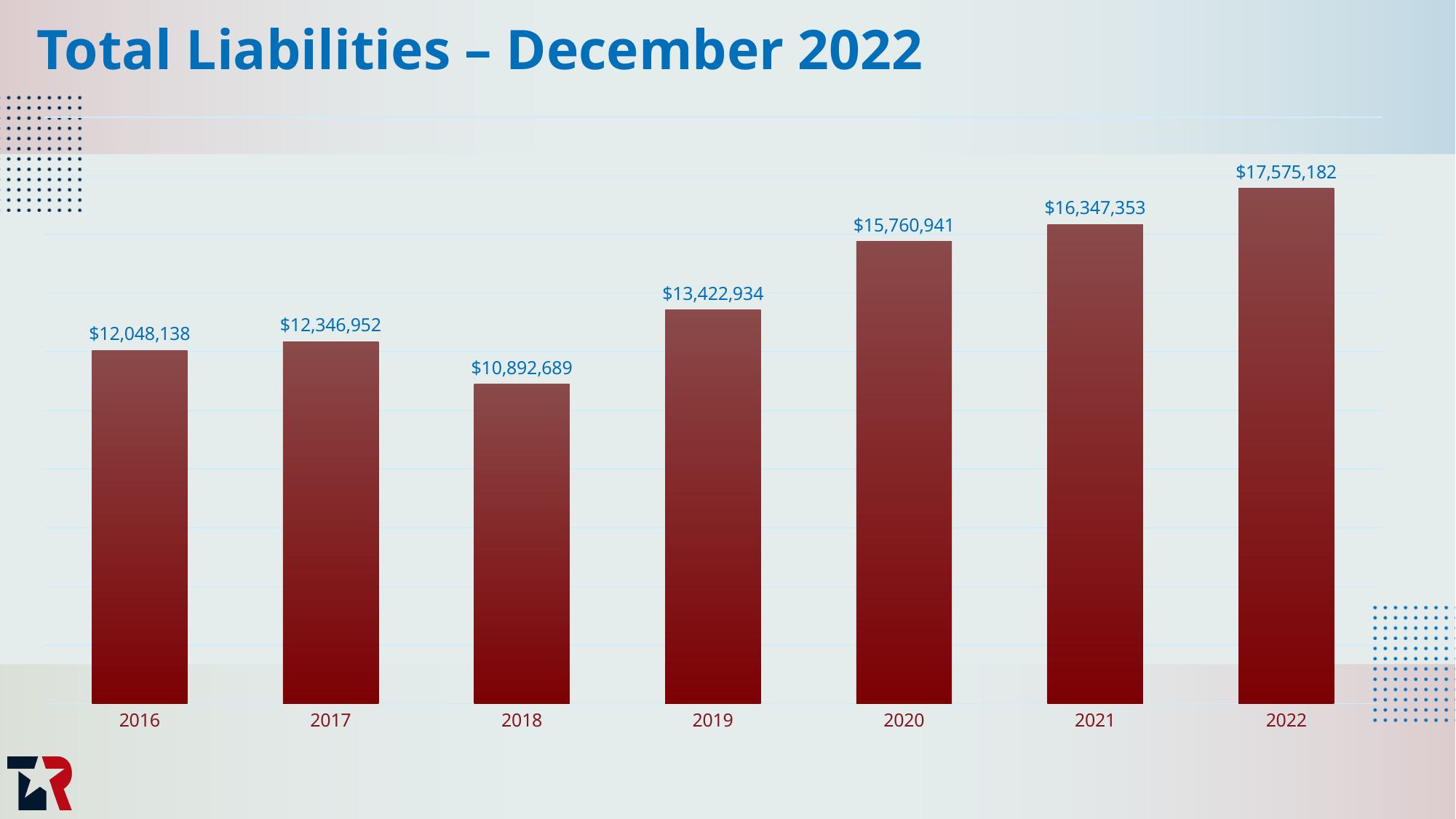
What is the title of the slide? Total Liabilities – December 2022 What is the total liabilities value for 2016? $12,048,138 How many years are shown on the chart? 7 What is the difference in total liabilities between 2022 and 2021? $1,227,829 Which year has the lowest total liabilities? 2018 What is the difference in total liabilities between 2019 and 2018? $2,530,245 Do total liabilities generally rise or fall from 2018 to 2022? Rise Which year has the highest total liabilities? 2022 What is the total liabilities value for 2018? $10,892,689 Which year has higher total liabilities, 2017 or 2019? 2019 What kind of chart is shown on the slide? Bar chart What is the total liabilities value for 2020? $15,760,941